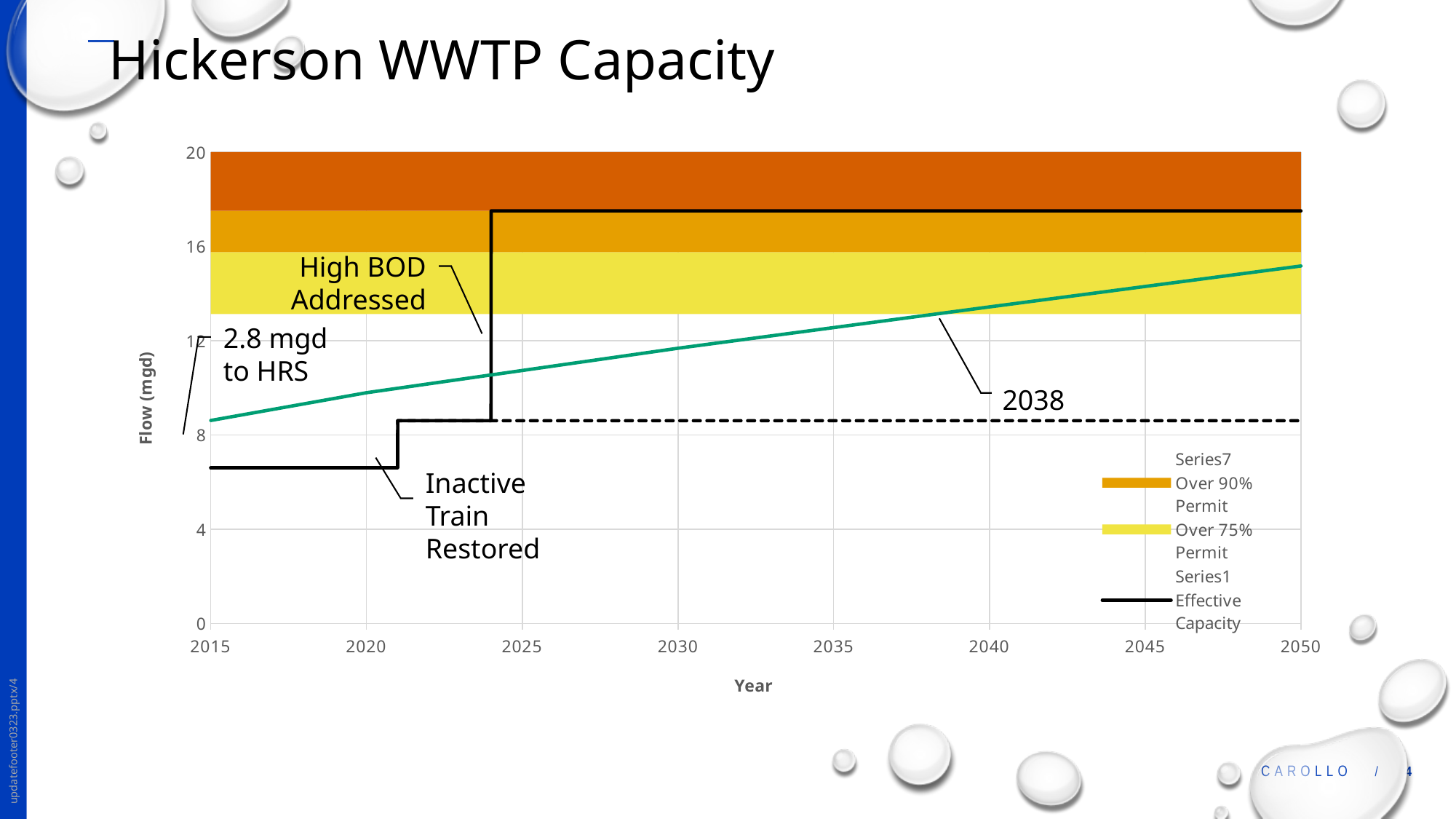
How many entries does the legend list? 5 What is the label of the vertical axis? Flow (mgd) Does the green projected flow line rise or fall from 2015 to 2050? rise Is the Effective Capacity line after 2025 greater or less than 16? greater Is the value of the green flow line in 2015 greater or less than 12? less According to the annotation, how much flow is sent to HRS? 2.8 mgd Is the Effective Capacity line in 2015 greater or less than 8? less What kind of chart is shown on the slide? combination area and line chart Which year is called out by the annotation where the green flow line crosses into the Over 75% Permit band? 2038 What is the title of the chart on the slide? Hickerson WWTP Capacity